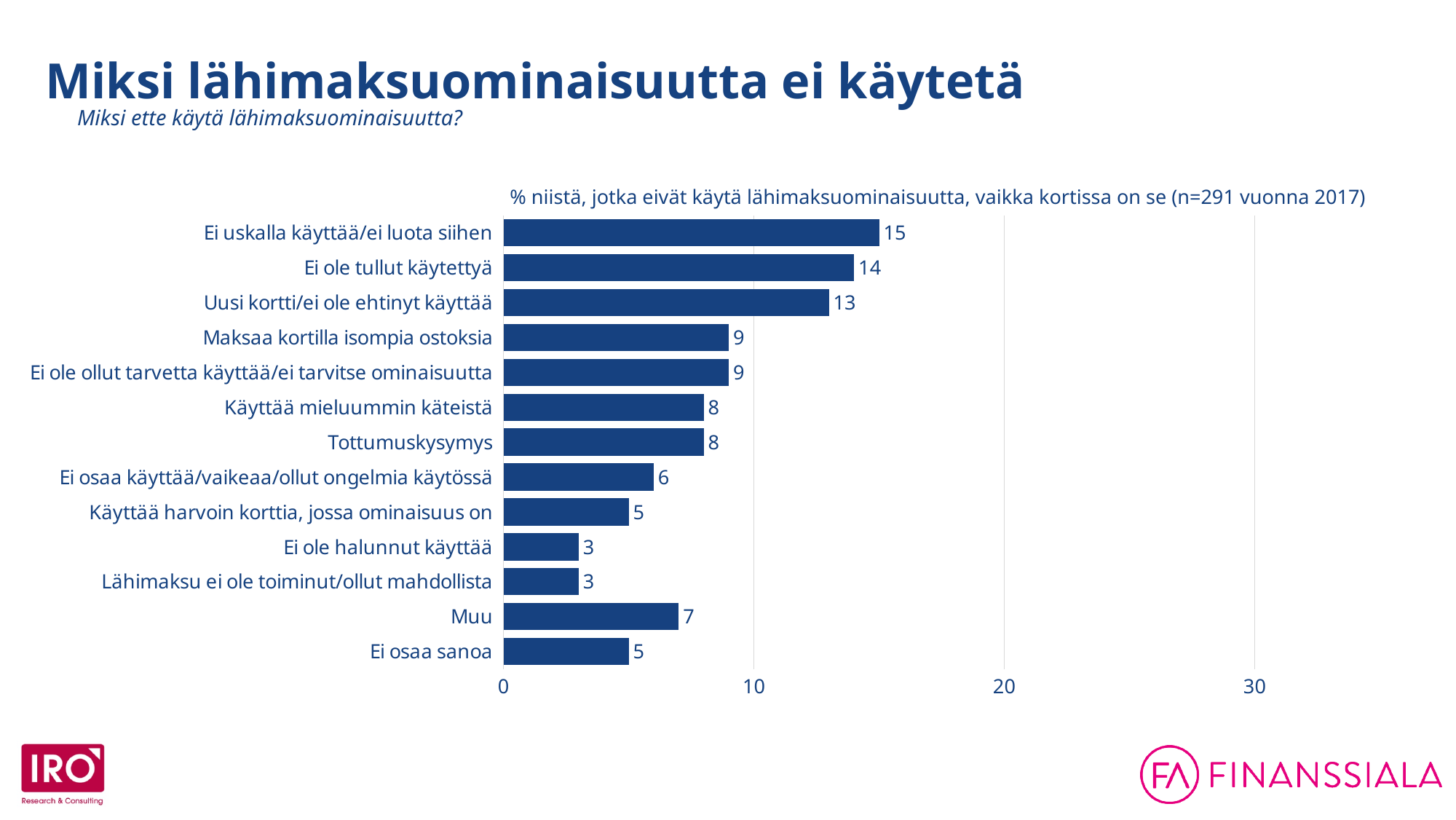
How many categories are shown in the chart? 13 What is the sample size (n) stated in the chart's subtitle? n=291 Which is larger, the value for "Maksaa kortilla isompia ostoksia" or the value for "Tottumuskysymys"? Maksaa kortilla isompia ostoksia What is the difference between the values for "Ei ole tullut käytettyä" and "Ei osaa käyttää/vaikeaa/ollut ongelmia käytössä"? 8 What is the value for "Uusi kortti/ei ole ehtinyt käyttää"? 13 What is the value for "Muu"? 7 What is the difference between the values for "Ei uskalla käyttää/ei luota siihen" and "Ei ole halunnut käyttää"? 12 Which category has the highest value? Ei uskalla käyttää/ei luota siihen What is the value for "Ei uskalla käyttää/ei luota siihen"? 15 What kind of chart is shown on the slide? bar chart What is the value for "Käyttää harvoin korttia, jossa ominaisuus on"? 5 Is the value for "Ei ole tullut käytettyä" greater or less than 10? greater